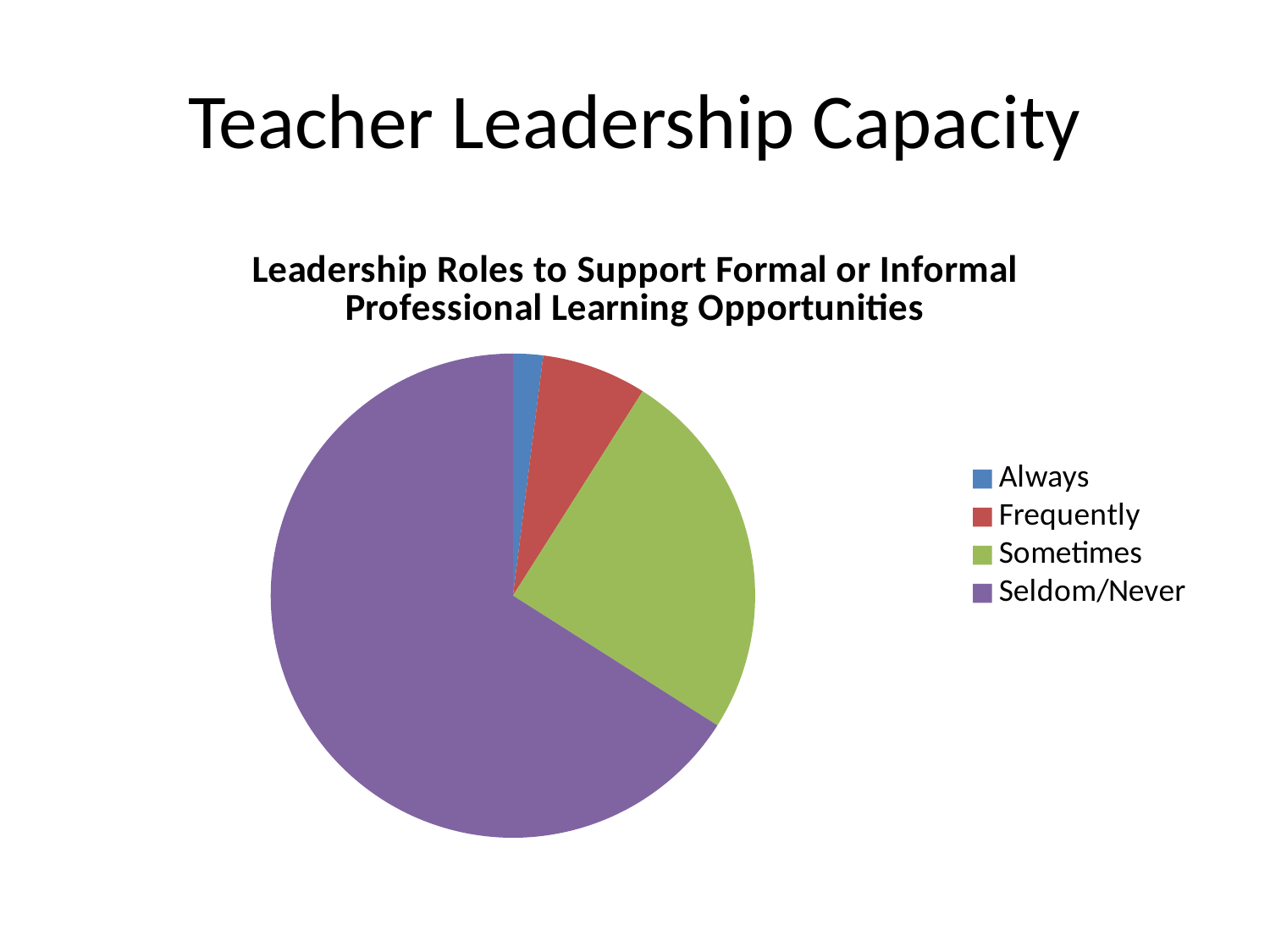
What kind of chart is shown on the slide? pie chart Which category has the smallest slice of the pie? Always Does the Seldom/Never slice make up more or less than half of the pie? more Which slice is larger, Frequently or Always? Frequently Which slice is larger, Sometimes or Frequently? Sometimes Which category has the largest slice of the pie? Seldom/Never How many categories does the pie chart show? 4 What colour is the Sometimes slice? green Which slice is larger, Seldom/Never or Sometimes? Seldom/Never What is the title of the chart? Leadership Roles to Support Formal or Informal Professional Learning Opportunities